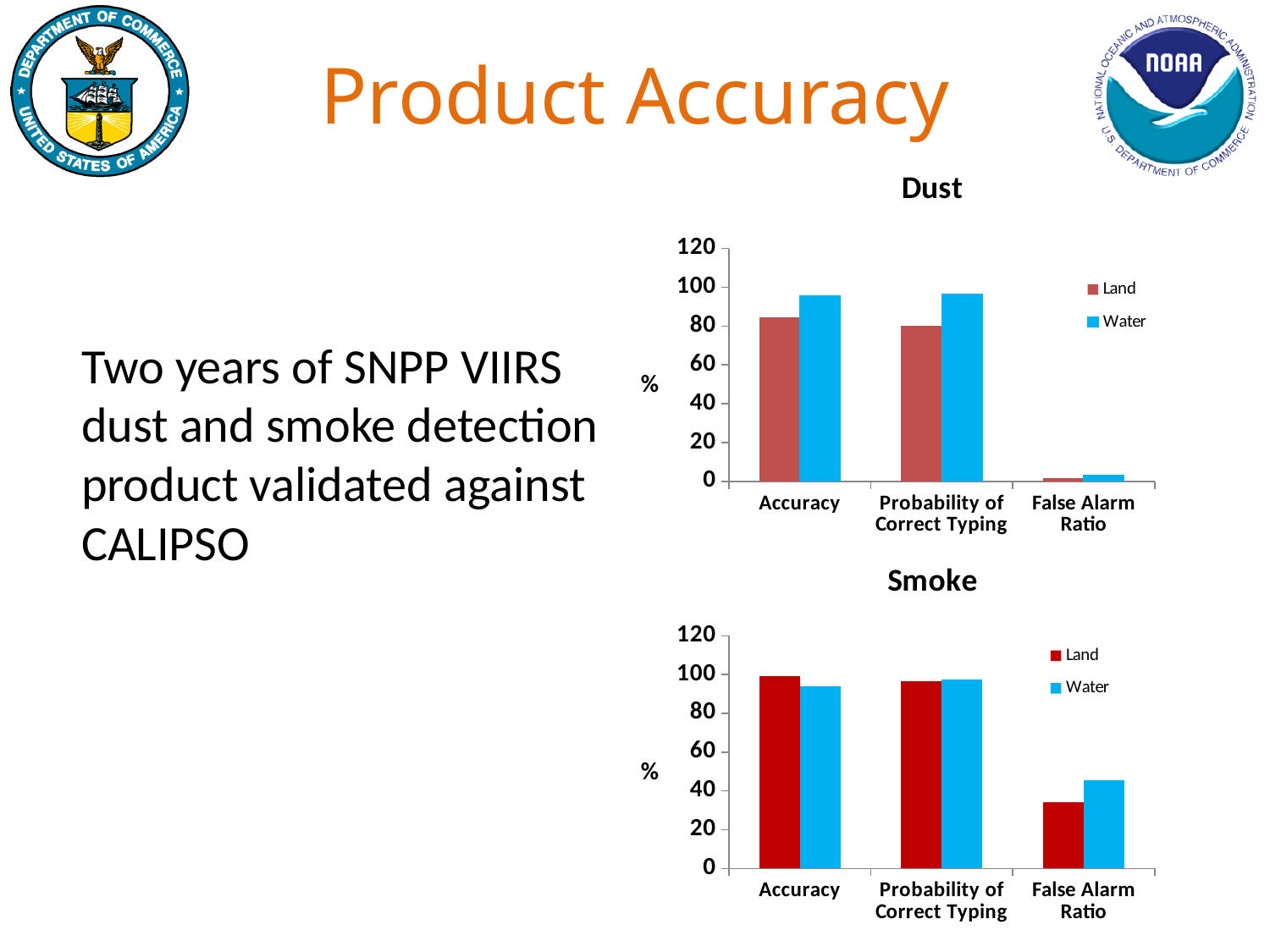
On the Smoke chart, is the Water value for False Alarm Ratio greater or less than 40? greater On the Smoke chart, which category has the lowest Water value? False Alarm Ratio On the Dust chart, how many categories are shown on the x axis? 3 On the Smoke chart, what label is shown on the y axis? % On the Dust chart, what kind of chart is shown? bar chart On the Dust chart, which is larger for Accuracy, Land or Water? Water On the Dust chart, which category has the lowest Land value? False Alarm Ratio On the Dust chart, is the Land value for Accuracy greater or less than 80? greater On the Dust chart, is the Water value for Probability of Correct Typing greater or less than 80? greater On the Smoke chart, which is larger for Accuracy, Land or Water? Land On the Dust chart, how many series does the legend list? 2